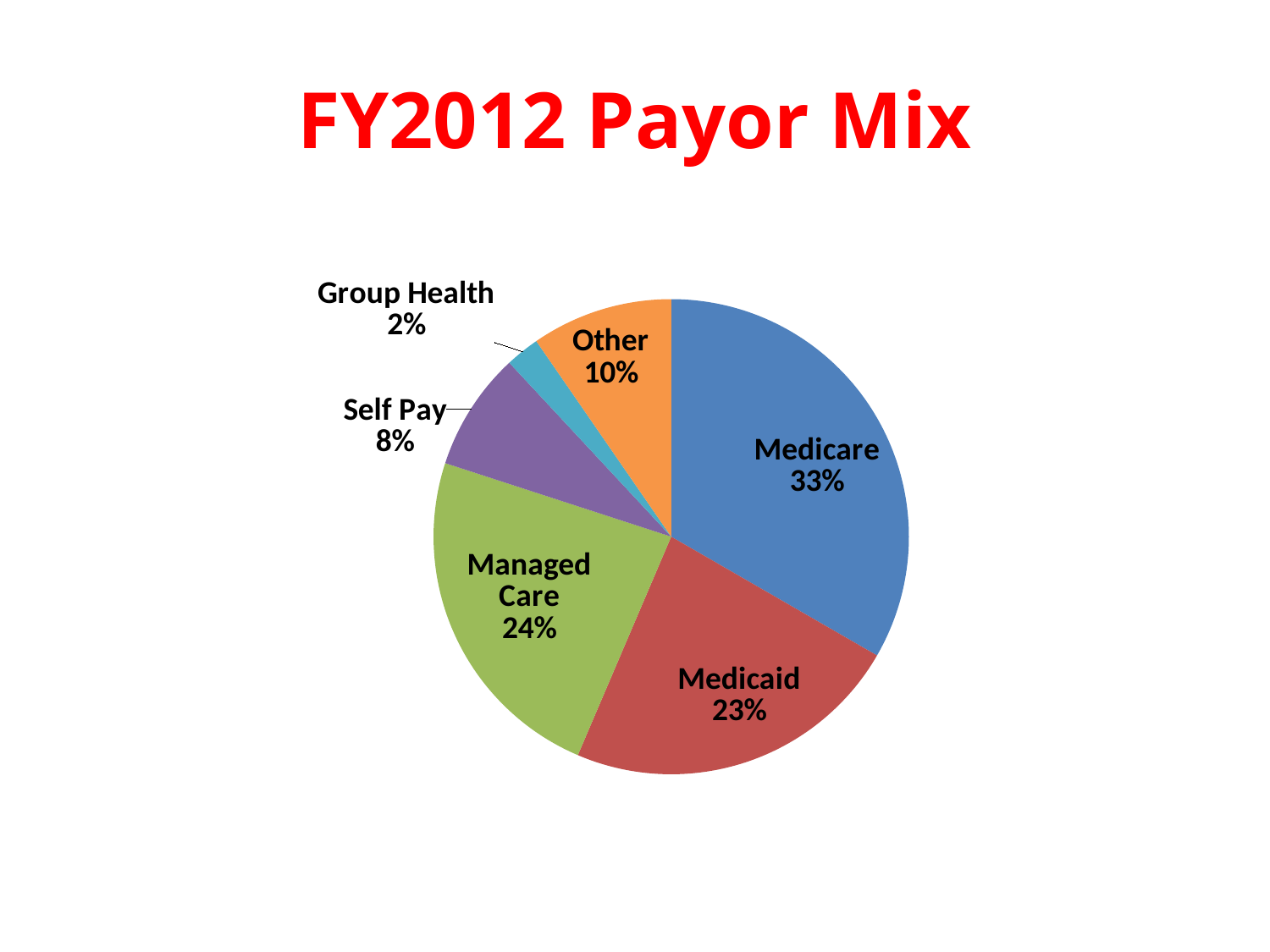
Which payor has the largest share of the pie? Medicare What kind of chart is shown on the slide? pie chart What is the value shown for Self Pay? 8% What is the value shown for Group Health? 2% How many slices does the pie chart have? 6 Which is larger, the share for Other or the share for Self Pay? Other What is the value shown for Managed Care? 24% What is the difference in percentage points between Medicare and Medicaid? 10 What share of the pie does Medicare represent? 33% What colour is the Medicaid slice? red Which payor has the smallest share of the pie? Group Health What is the title of the chart? FY2012 Payor Mix